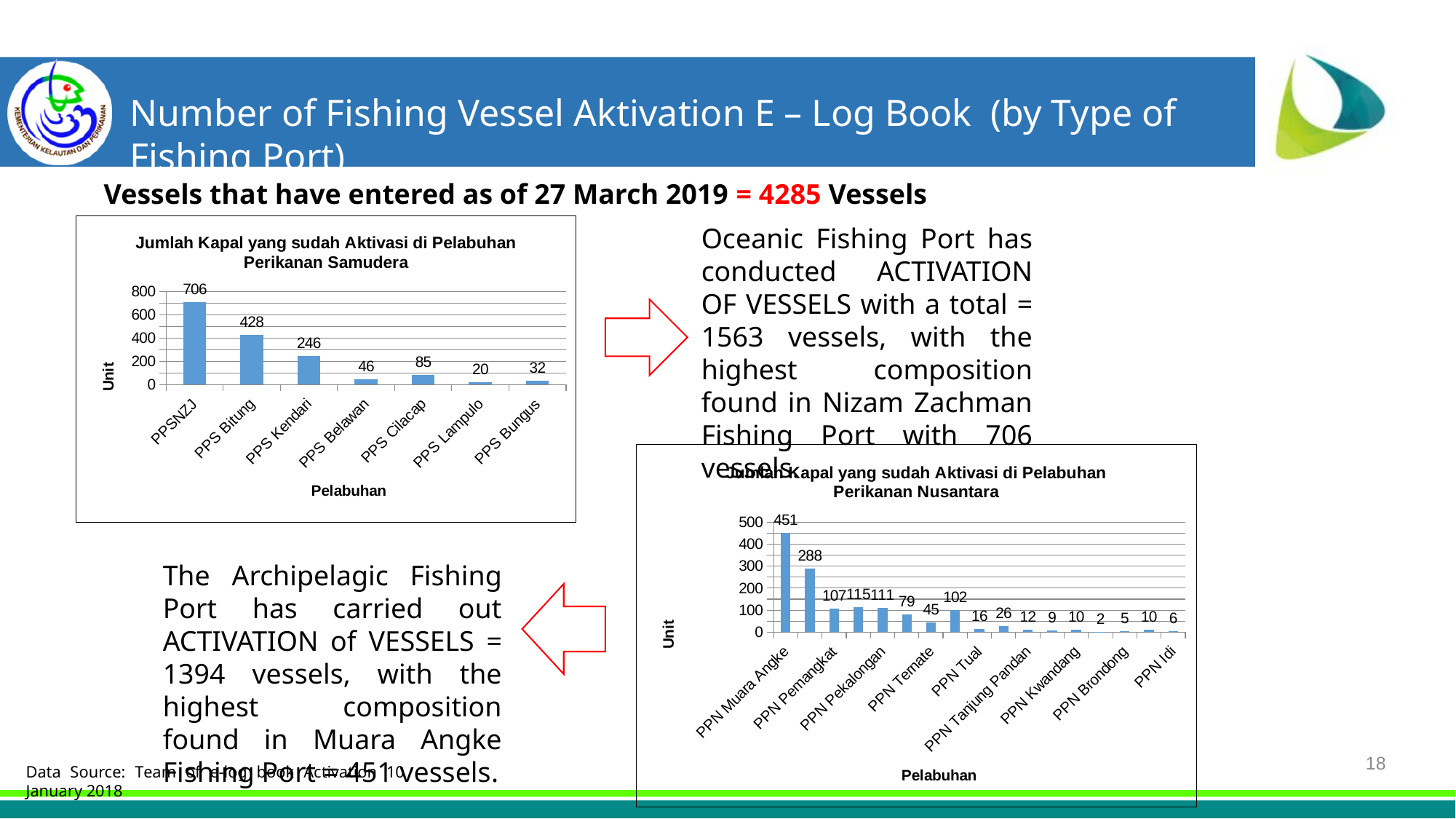
In the chart titled 'Jumlah Kapal yang sudah Aktivasi di Pelabuhan Perikanan Nusantara', which port has the highest value? PPN Muara Angke How many bars are plotted in the chart titled 'Jumlah Kapal yang sudah Aktivasi di Pelabuhan Perikanan Nusantara'? 17 In the chart titled 'Jumlah Kapal yang sudah Aktivasi di Pelabuhan Perikanan Samudera', what is the value for PPS Cilacap? 85 In the chart titled 'Jumlah Kapal yang sudah Aktivasi di Pelabuhan Perikanan Samudera', what is the value for PPS Bitung? 428 In the chart titled 'Jumlah Kapal yang sudah Aktivasi di Pelabuhan Perikanan Samudera', which port has the highest value? PPSNZJ What is the y-axis label of the chart titled 'Jumlah Kapal yang sudah Aktivasi di Pelabuhan Perikanan Nusantara'? Unit What type of chart is the one titled 'Jumlah Kapal yang sudah Aktivasi di Pelabuhan Perikanan Samudera'? Bar chart In the chart titled 'Jumlah Kapal yang sudah Aktivasi di Pelabuhan Perikanan Samudera', which port has the lowest value? PPS Lampulo In the chart titled 'Jumlah Kapal yang sudah Aktivasi di Pelabuhan Perikanan Samudera', what is the difference between PPSNZJ and PPS Bitung? 278 In the chart titled 'Jumlah Kapal yang sudah Aktivasi di Pelabuhan Perikanan Samudera', which is larger: PPS Belawan or PPS Bungus? PPS Belawan In the chart titled 'Jumlah Kapal yang sudah Aktivasi di Pelabuhan Perikanan Nusantara', what is the value for PPN Muara Angke? 451 How many ports are shown in the chart titled 'Jumlah Kapal yang sudah Aktivasi di Pelabuhan Perikanan Samudera'? 7